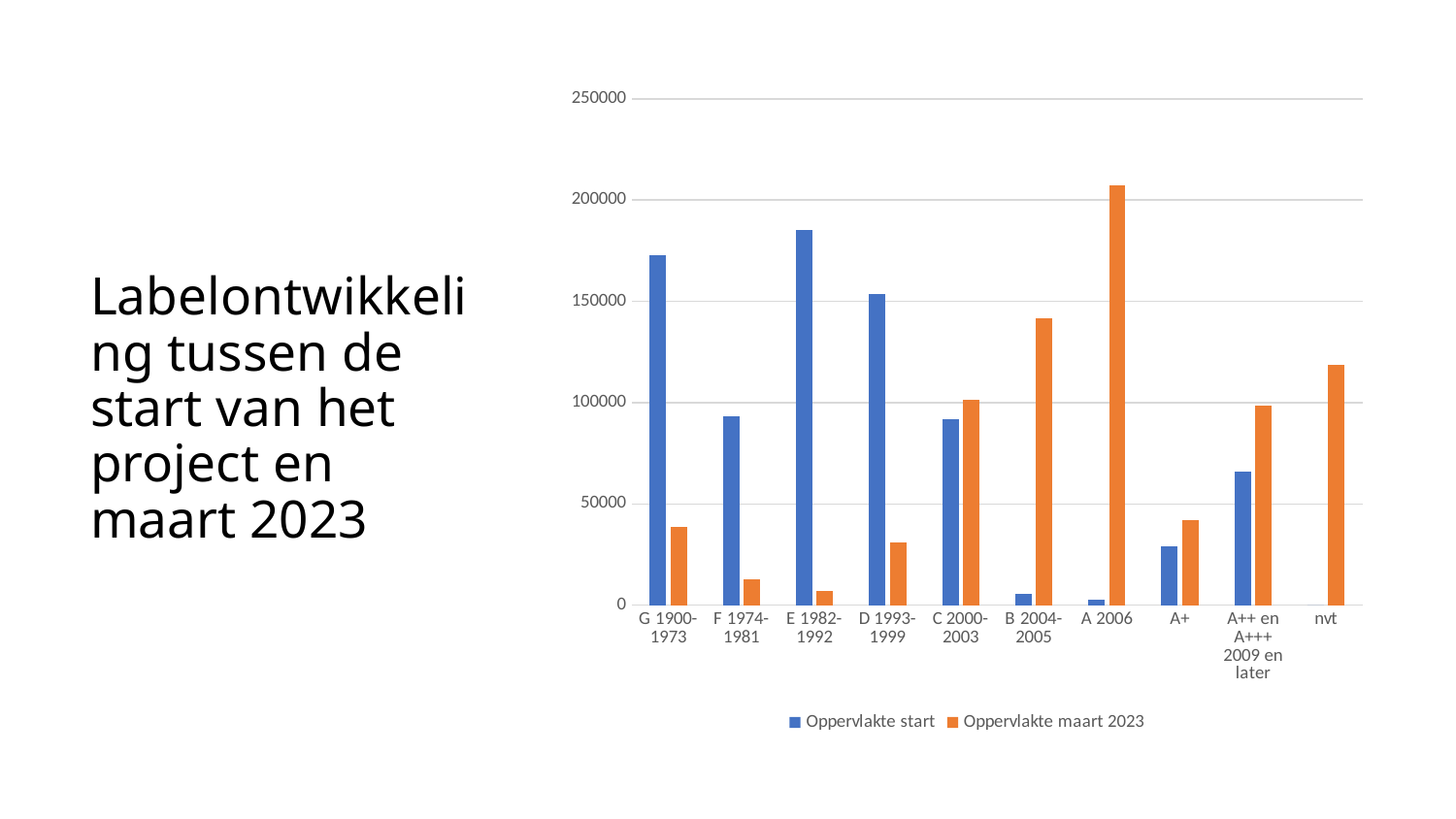
Is the Oppervlakte start value for E 1982-1992 greater or less than 150000? greater Which category has the highest value for Oppervlakte maart 2023? A 2006 For B 2004-2005, which is larger: Oppervlakte start or Oppervlakte maart 2023? Oppervlakte maart 2023 For G 1900-1973, which is larger: Oppervlakte start or Oppervlakte maart 2023? Oppervlakte start How many series does the legend list? 2 Which colour represents the Oppervlakte maart 2023 series? orange Which category has the highest value for Oppervlakte start? E 1982-1992 Is the Oppervlakte maart 2023 value for nvt greater or less than 100000? greater How many categories are shown on the x axis? 10 Is the Oppervlakte maart 2023 value for G 1900-1973 greater or less than 50000? less What kind of chart is shown on the slide? bar chart